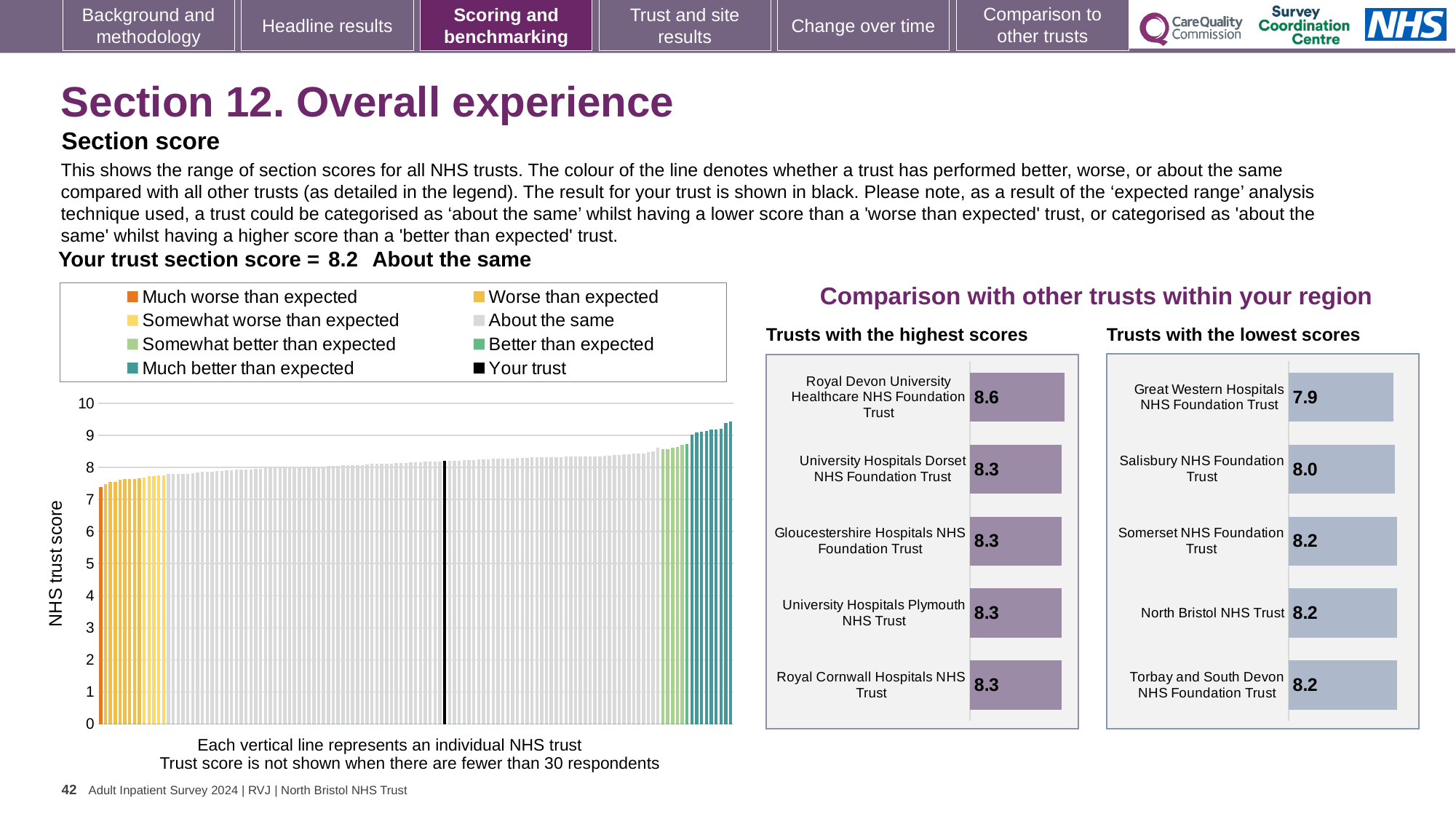
In the 'Trusts with the lowest scores' chart, which trust has the lowest score? Great Western Hospitals NHS Foundation Trust In the 'Trusts with the lowest scores' chart, what is the score for Great Western Hospitals NHS Foundation Trust? 7.9 In the 'Trusts with the lowest scores' chart, what is the difference between the scores of North Bristol NHS Trust and Great Western Hospitals NHS Foundation Trust? 0.3 In the 'Trusts with the lowest scores' chart, which has the higher score: Salisbury NHS Foundation Trust or Somerset NHS Foundation Trust? Somerset NHS Foundation Trust In the 'Trusts with the highest scores' chart, which trust has the highest score? Royal Devon University Healthcare NHS Foundation Trust How many entries does the legend of the large chart on the left list? 8 How many trusts are shown in the 'Trusts with the highest scores' chart? 5 What kind of chart is the large chart on the left showing NHS trust scores? Bar chart In the large chart on the left, what is the section score for your trust (the black line)? 8.2 In the 'Trusts with the highest scores' chart, what is the score for Royal Devon University Healthcare NHS Foundation Trust? 8.6 In the 'Trusts with the highest scores' chart, what is the difference between the scores of Royal Devon University Healthcare NHS Foundation Trust and University Hospitals Dorset NHS Foundation Trust? 0.3 In the large chart on the left, do the trust scores rise or fall from left to right? Rise